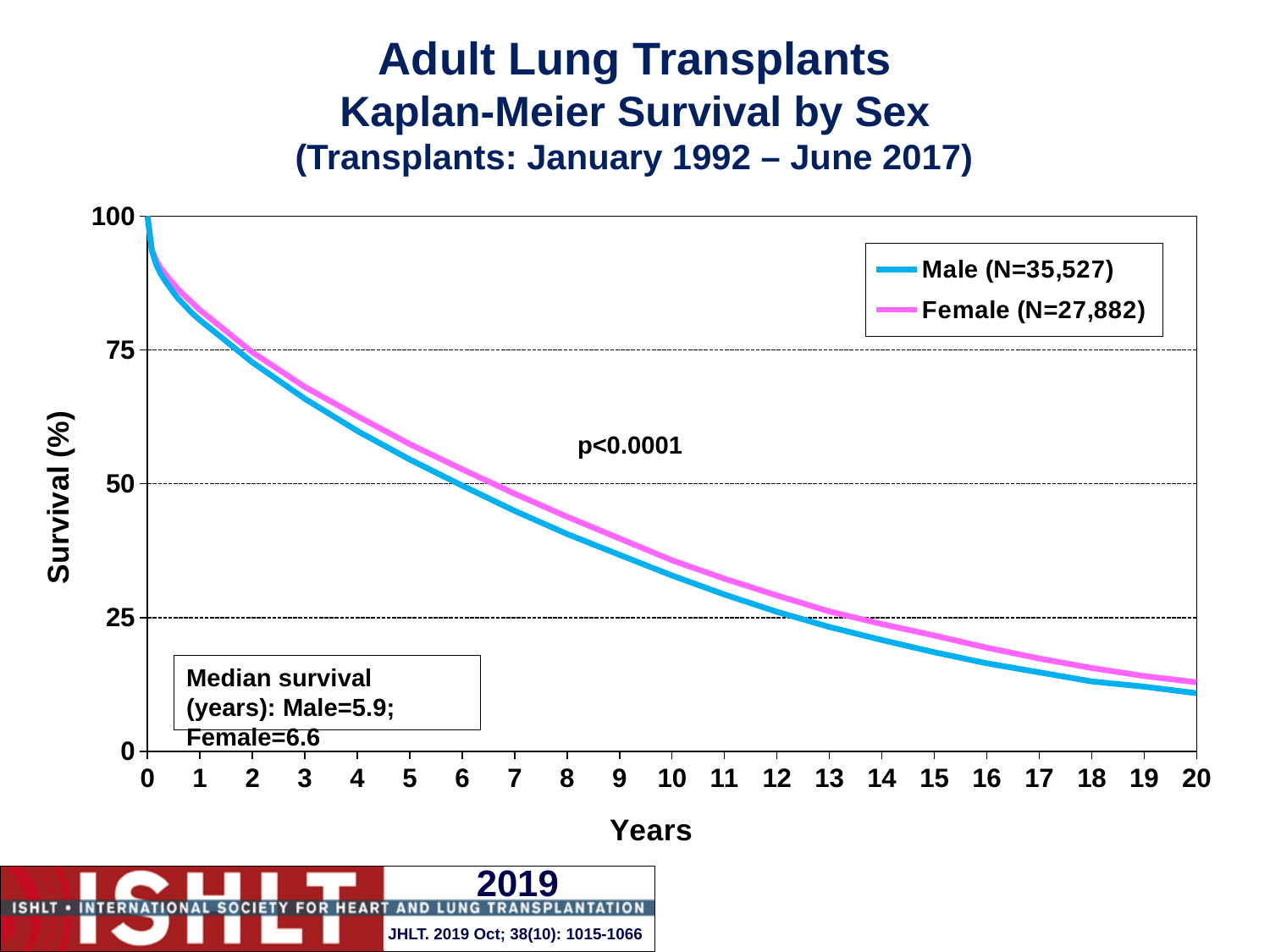
At 10 years, which curve shows higher survival, Male or Female? Female What type of chart is shown on the slide? line chart What is the N for the Female series shown in the legend? 27,882 What is the median survival in years for males, as stated on the slide? 5.9 Is the survival value for Male at 20 years greater or less than 25? less What is the N for the Male series shown in the legend? 35,527 What is the median survival in years for females, as stated on the slide? 6.6 Is the survival value for Male at 10 years greater or less than 50? less Is the survival value for Female at 5 years greater or less than 50? greater Do the survival curves rise or fall as years increase? fall How many series does the legend list? 2 Which sex has the longer median survival according to the slide? Female